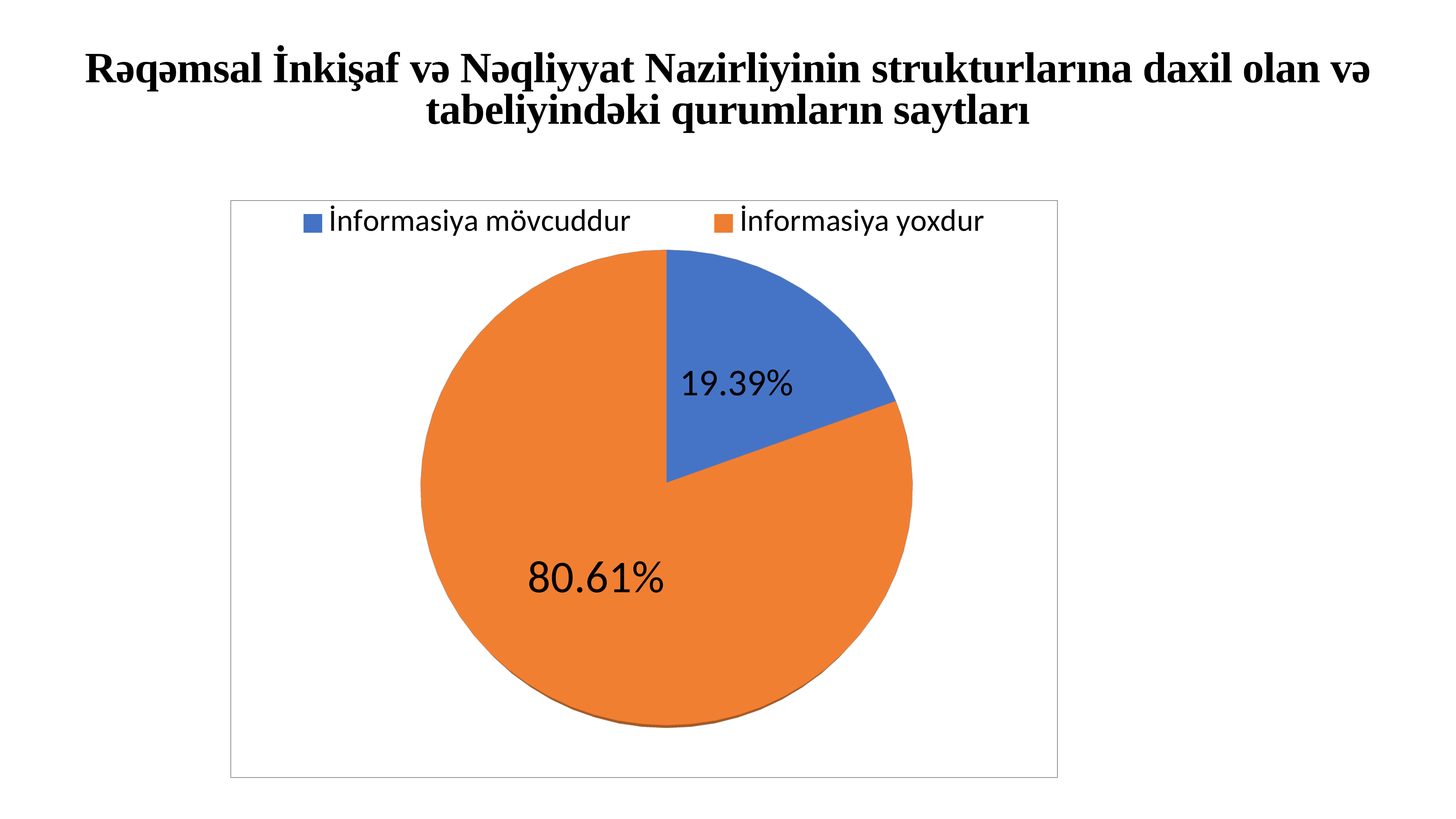
What kind of chart is shown on the slide? pie chart What share of the pie does "İnformasiya yoxdur" represent? 80.61% What share of the pie does "İnformasiya mövcuddur" represent? 19.39% What colour is the slice for "İnformasiya mövcuddur"? blue What is the difference in percentage points between the "İnformasiya yoxdur" and "İnformasiya mövcuddur" slices? 61.22 Which is larger: the slice for "İnformasiya mövcuddur" or the slice for "İnformasiya yoxdur"? İnformasiya yoxdur Which category has the largest slice of the pie? İnformasiya yoxdur What colour is the slice for "İnformasiya yoxdur"? orange Which category has the smallest slice of the pie? İnformasiya mövcuddur How many entries does the legend list? 2 How many slices does the pie chart have? 2